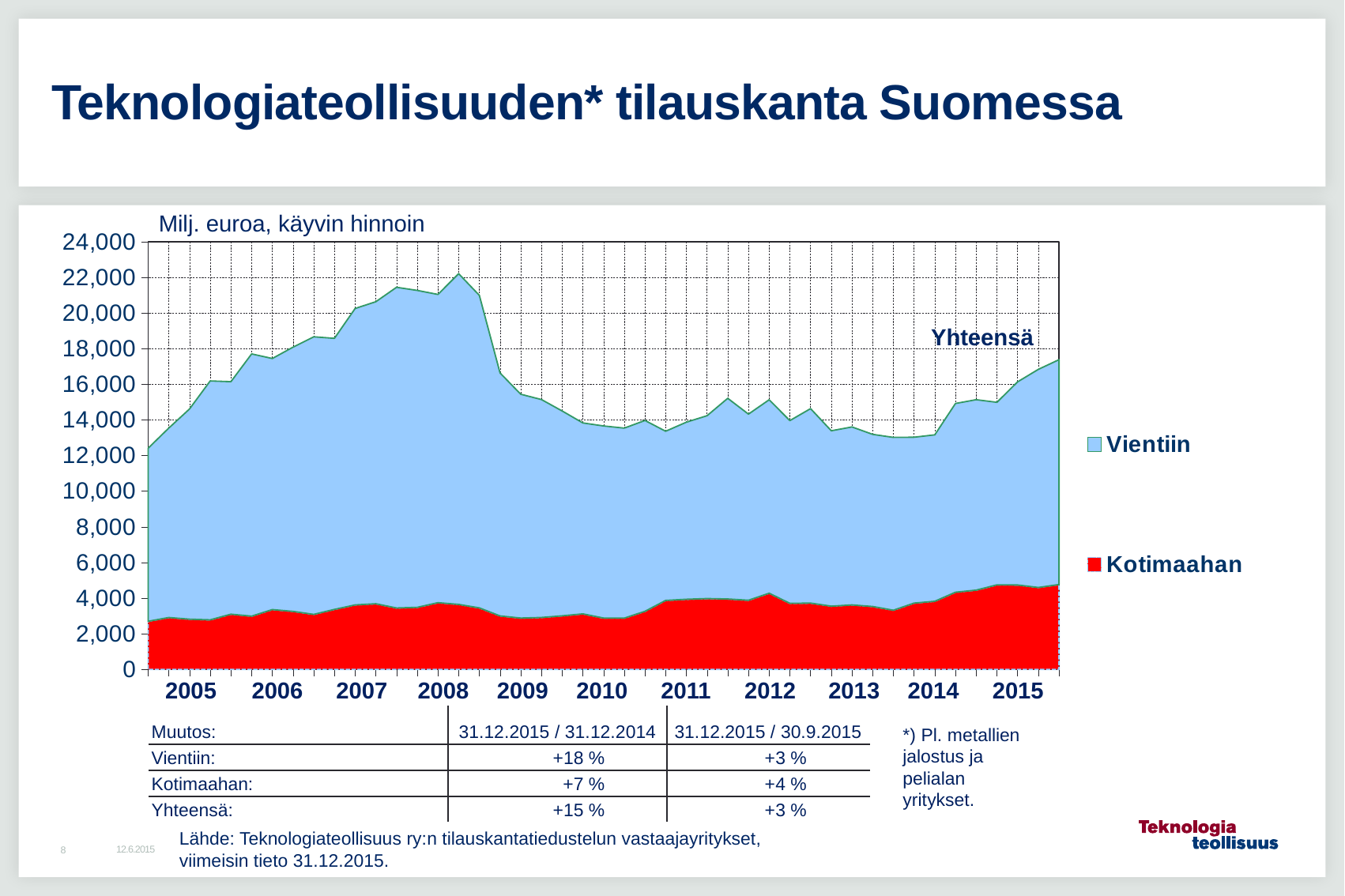
Does the total order backlog rise or fall from the 2008 peak to 2009? Fall Which series is larger throughout the chart, Vientiin or Kotimaahan? Vientiin Does the total order backlog rise or fall between 2005 and the peak in 2008? Rise In which year does the total (Yhteensä) order backlog reach its highest peak? 2008 Is the peak total value in 2008 greater or less than 20,000? greater How many series does the chart legend list? 2 Is the total value at the end of 2015 greater or less than 18,000? less How many years are labelled on the chart's x axis? 11 What unit label is shown above the chart's y axis? Milj. euroa, käyvin hinnoin What are the two series named in the chart legend? Vientiin and Kotimaahan What kind of chart is shown on the slide? Stacked area chart Is the Kotimaahan value at the end of 2015 greater or less than 4,000? greater